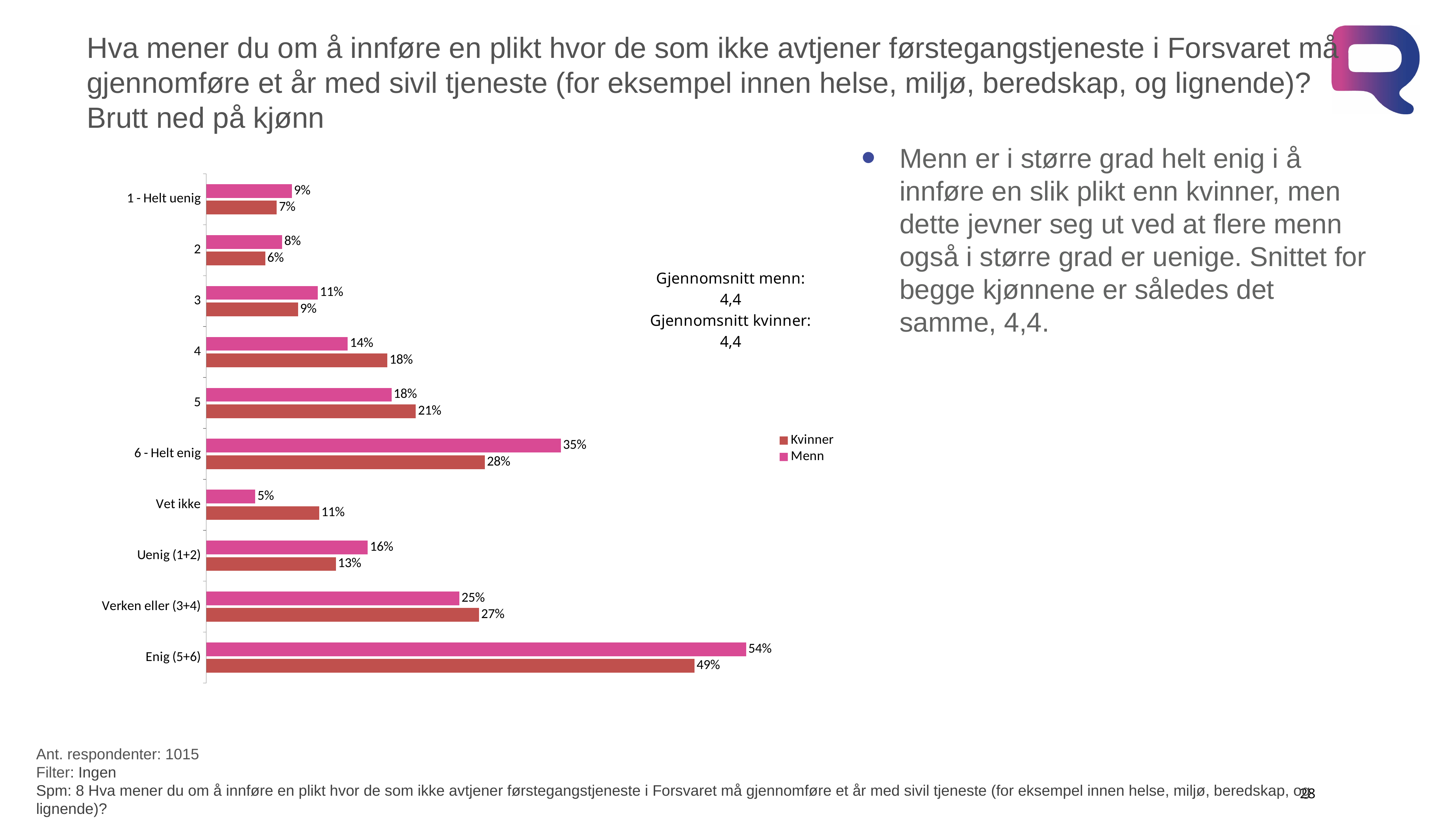
How many series does the legend list? 2 In the category '4', which series has the larger value, Menn or Kvinner? Kvinner Which category has the highest value for Menn? Enig (5+6) What is the value for Menn in the category '6 - Helt enig'? 35% Which series is shown in pink in the legend? Menn What is the value for Kvinner in the category 'Enig (5+6)'? 49% How many categories are shown on the chart? 10 Which category has the lowest value for Kvinner? 2 What is the difference between Menn and Kvinner in the category 'Enig (5+6)'? 5% What type of chart is shown on the slide? bar chart What is the value for Kvinner in the category 'Vet ikke'? 11% What is the difference between Kvinner and Menn in the category 'Vet ikke'? 6%